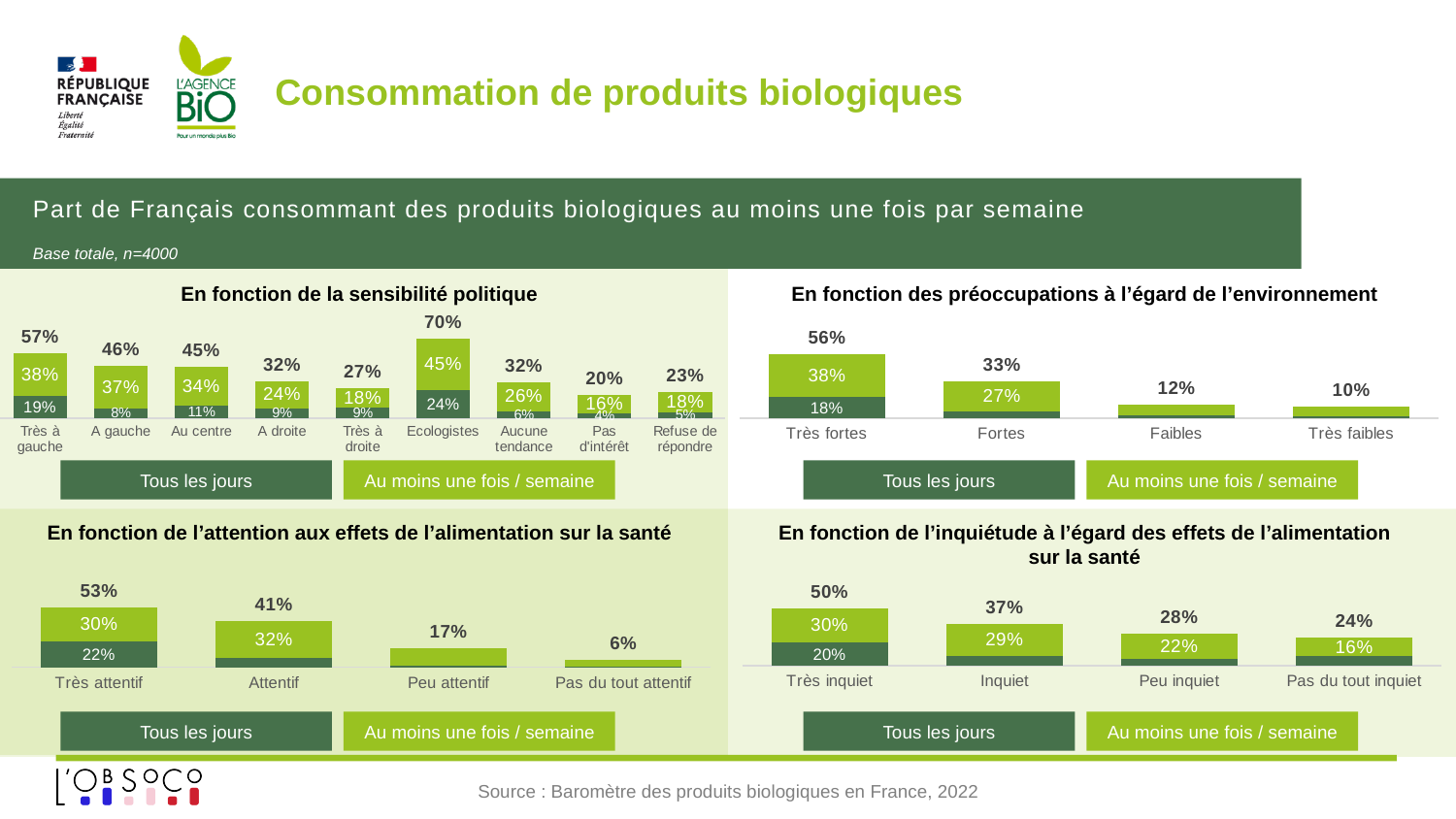
In the chart 'En fonction de l'inquiétude à l'égard des effets de l'alimentation sur la santé', what is the total for Pas du tout inquiet? 24% In the chart 'En fonction de l'attention aux effets de l'alimentation sur la santé', which is larger: the total for Très attentif or the total for Attentif? Très attentif How many series does the legend list in the chart 'En fonction de l'inquiétude à l'égard des effets de l'alimentation sur la santé'? 2 In the chart 'En fonction de l'attention aux effets de l'alimentation sur la santé', what is the 'Au moins une fois / semaine' value for Attentif? 32% In the chart 'En fonction de la sensibilité politique', how many categories are shown on the x axis? 9 In the chart 'En fonction de la sensibilité politique', what is the 'Tous les jours' value for Très à gauche? 19% In the chart 'En fonction des préoccupations à l'égard de l'environnement', do the totals rise or fall from Très fortes to Très faibles? fall In the chart 'En fonction de la sensibilité politique', which category has the lowest total? Pas d'intérêt In the chart 'En fonction des préoccupations à l'égard de l'environnement', what is the difference between the totals for Très fortes and Très faibles? 46% In the chart 'En fonction de la sensibilité politique', which category has the highest total? Ecologistes In the chart 'En fonction de la sensibilité politique', what is the total value shown above the bar for Ecologistes? 70% In the chart 'En fonction des préoccupations à l'égard de l'environnement', what is the total for Très fortes? 56%